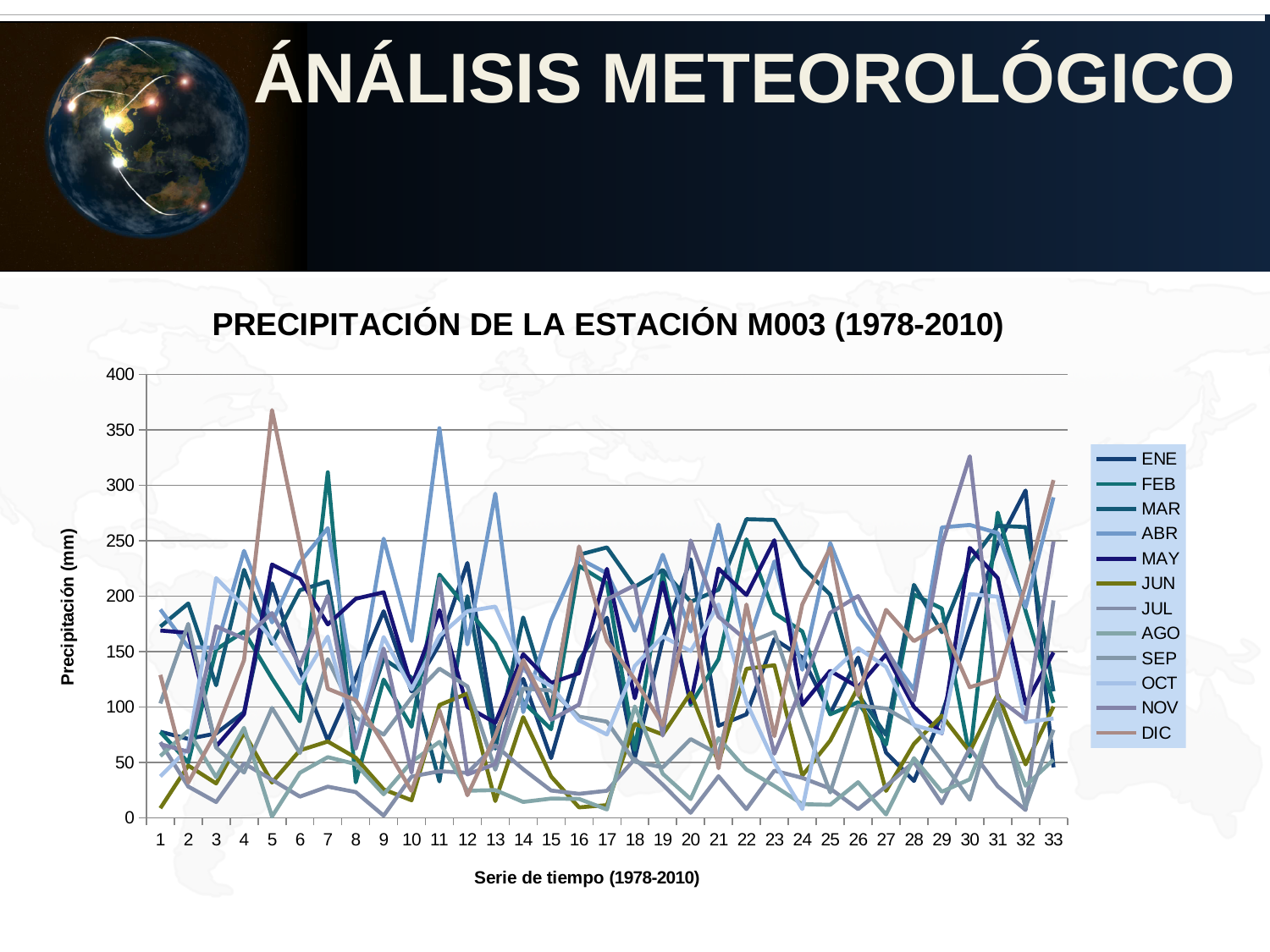
Is the value for JUN at point 1 greater or less than 50? less Is the value for ABR at point 11 greater or less than 300? greater Is the value for AGO at point 27 greater or less than 50? less What is the label of the y axis? Precipitación (mm) How many points are there along the x axis of the chart? 33 At point 5, which is larger, the value for DIC or the value for JUN? DIC What kind of chart is shown on the slide? line chart What is the title of the chart? PRECIPITACIÓN DE LA ESTACIÓN M003 (1978-2010) How many series does the legend list? 12